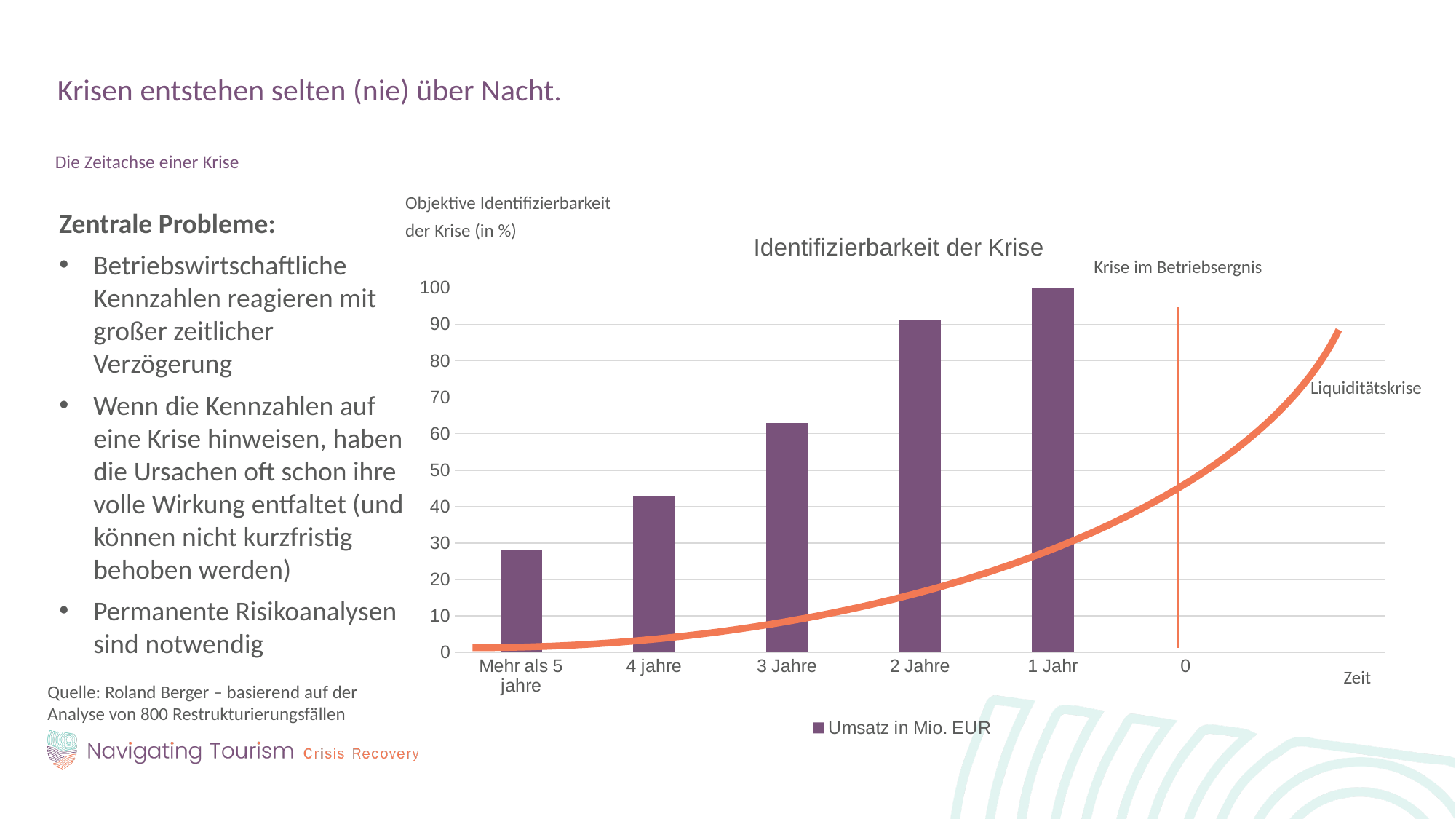
What kind of chart is shown on the slide? bar chart How many series does the legend list? 1 Which category has the highest bar? 1 Jahr Which is larger, the value for 2 Jahre or the value for 4 jahre? 2 Jahre Is the value for Mehr als 5 jahre greater or less than 40? less What is the title of the chart? Identifizierbarkeit der Krise Which category has the lowest bar? Mehr als 5 jahre How many bars are plotted in the chart? 5 What is the value for 1 Jahr? 100 Do the bar values rise or fall from Mehr als 5 jahre to 1 Jahr? rise What is the legend entry of the chart? Umsatz in Mio. EUR Is the value for 3 Jahre greater or less than 50? greater